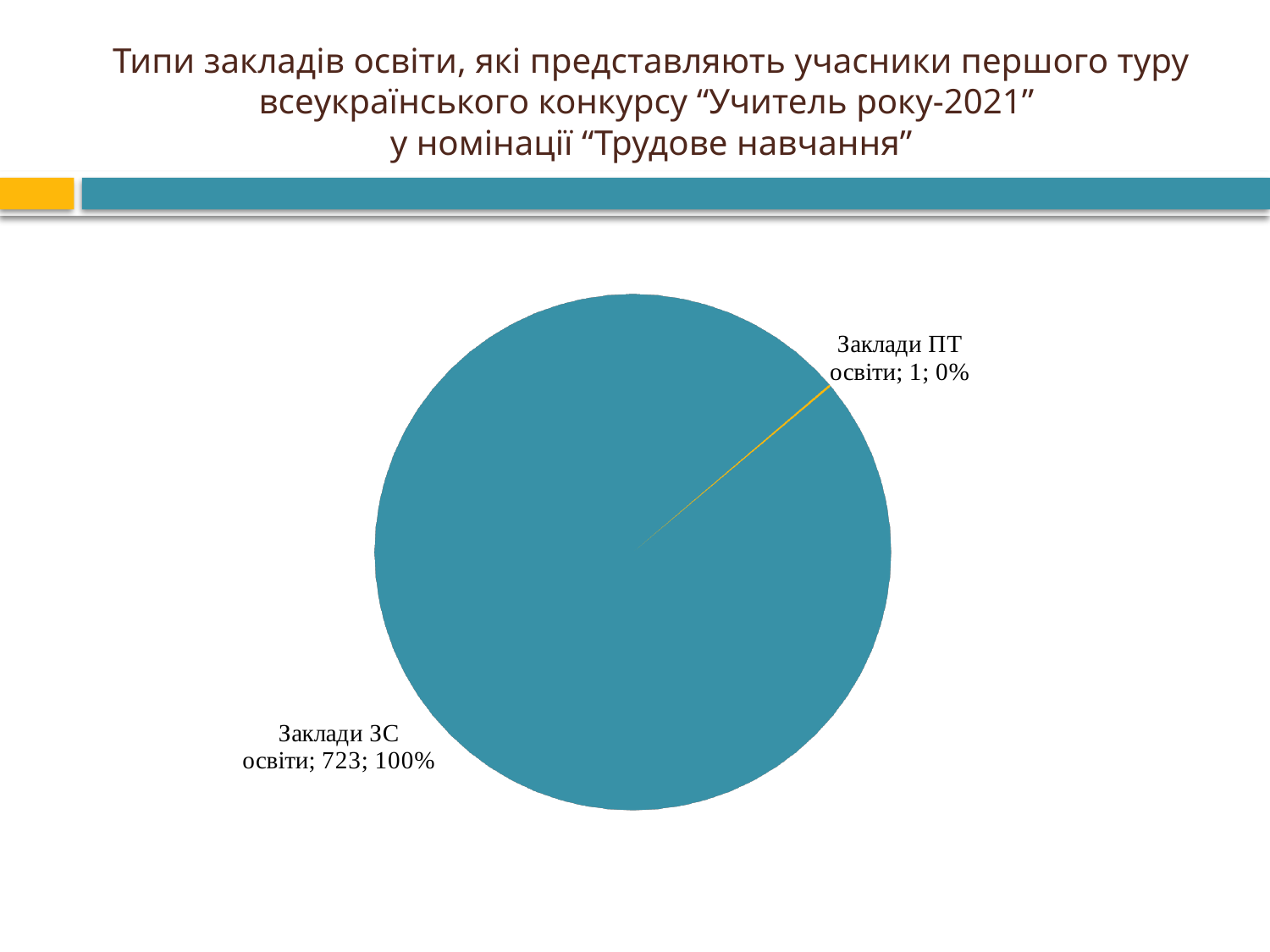
What is the difference between the values for Заклади ЗС освіти and Заклади ПТ освіти? 722 What is the value for Заклади ПТ освіти? 1 How many slices does the pie chart have? 2 Which category has the smallest slice? Заклади ПТ освіти What is the value for Заклади ЗС освіти? 723 What type of chart is shown on the slide? pie chart What colour is the slice for Заклади ЗС освіти? teal Which is larger, the value for Заклади ЗС освіти or Заклади ПТ освіти? Заклади ЗС освіти What is the total of the two values shown in the pie chart? 724 Which category has the largest slice? Заклади ЗС освіти What percentage share is shown for Заклади ЗС освіти? 100% What percentage share is shown for Заклади ПТ освіти? 0%